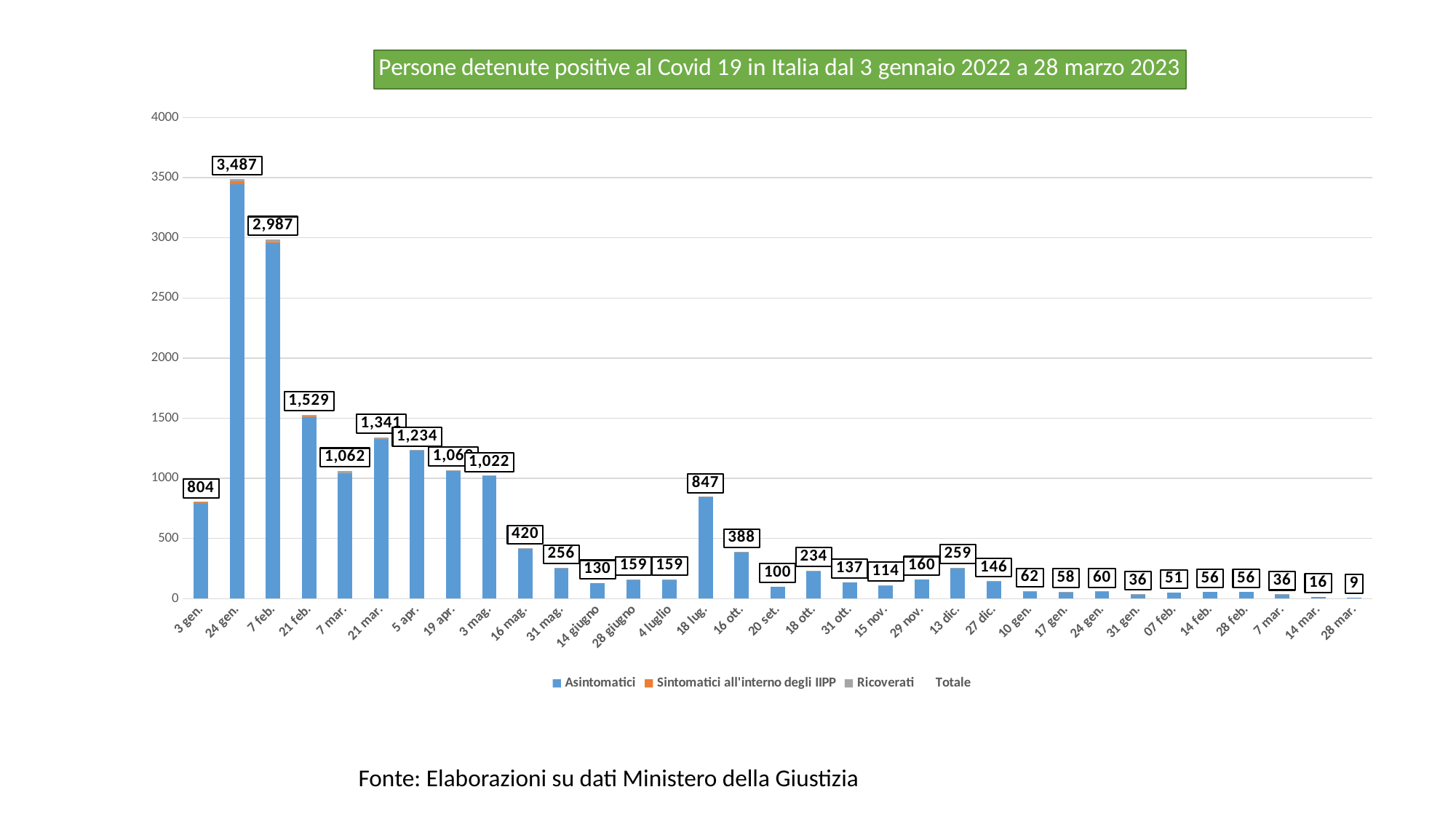
Is the value for 19 apr. greater or less than 500? greater How many dates are shown on the x axis? 33 How many series does the legend list? 4 What is the difference between the totals for 24 gen. (3,487) and 7 feb. (2,987)? 500 Which date has the highest total? 24 gen. What is the difference between the totals for 18 lug. and 16 ott.? 459 What is the total value shown for 18 lug.? 847 Which has a larger total, 13 dic. or 18 ott.? 13 dic. What is the total value shown for 16 mag.? 420 What is the total value shown for 20 set.? 100 Which date has the lowest total? 28 mar. What kind of chart is shown on the slide? bar chart